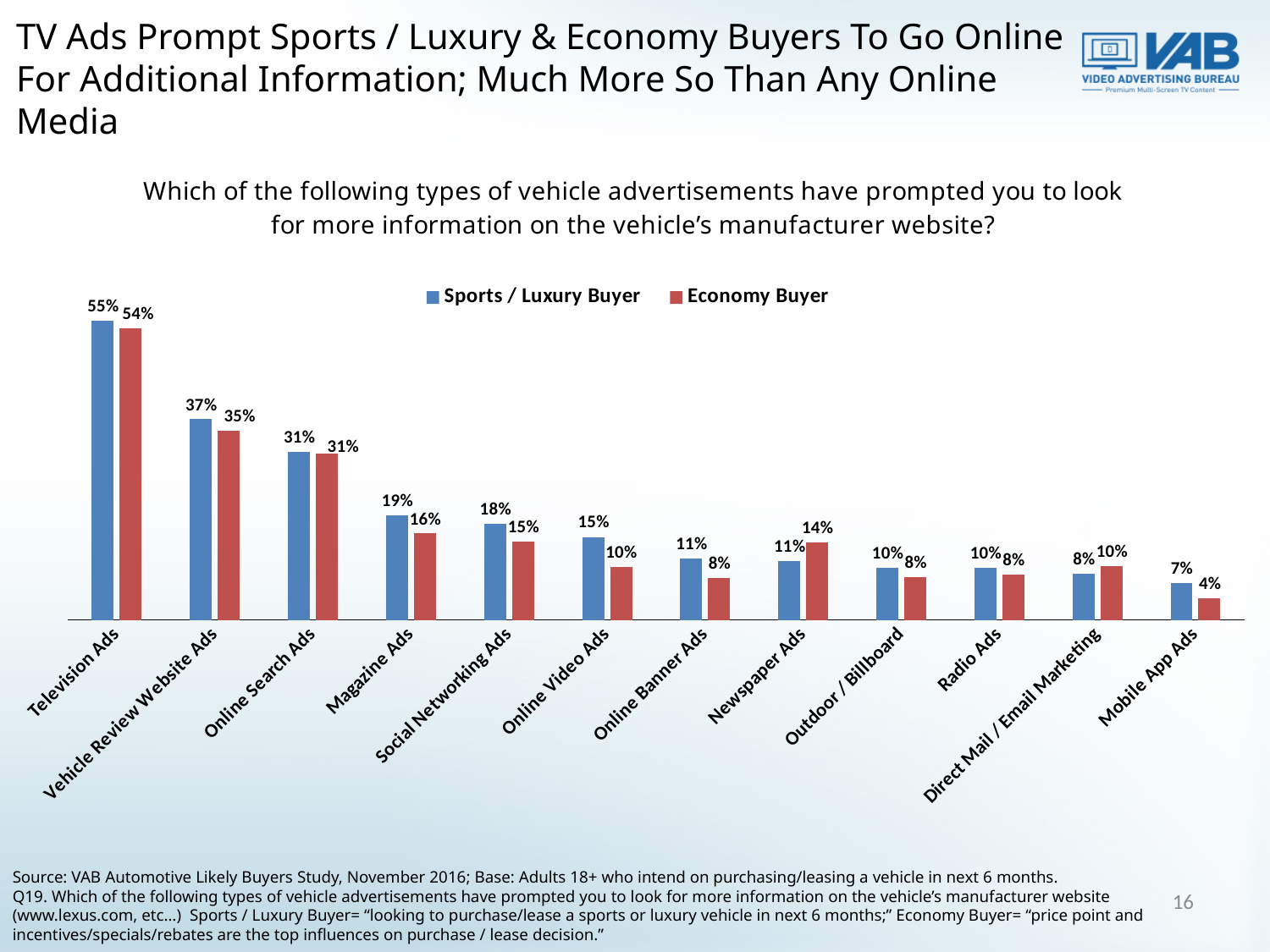
Which type of advertisement has the highest value for Sports / Luxury Buyers? Television Ads What is the difference between the Sports / Luxury Buyer and Economy Buyer values for Online Video Ads? 5% What is the Economy Buyer value for Vehicle Review Website Ads? 35% What is the Economy Buyer value for Mobile App Ads? 4% For Newspaper Ads, which is larger: the Sports / Luxury Buyer value or the Economy Buyer value? Economy Buyer How many types of vehicle advertisements are shown on the x axis? 12 Which type of advertisement has the lowest value for Economy Buyers? Mobile App Ads Which colour represents Economy Buyer in the chart? Red What percentage of Sports / Luxury Buyers said Television Ads prompted them to look for more information? 55% Do the Sports / Luxury Buyer values generally rise or fall from left to right along the x axis? Fall What kind of chart is shown on the slide? Bar chart How many series does the legend list? 2